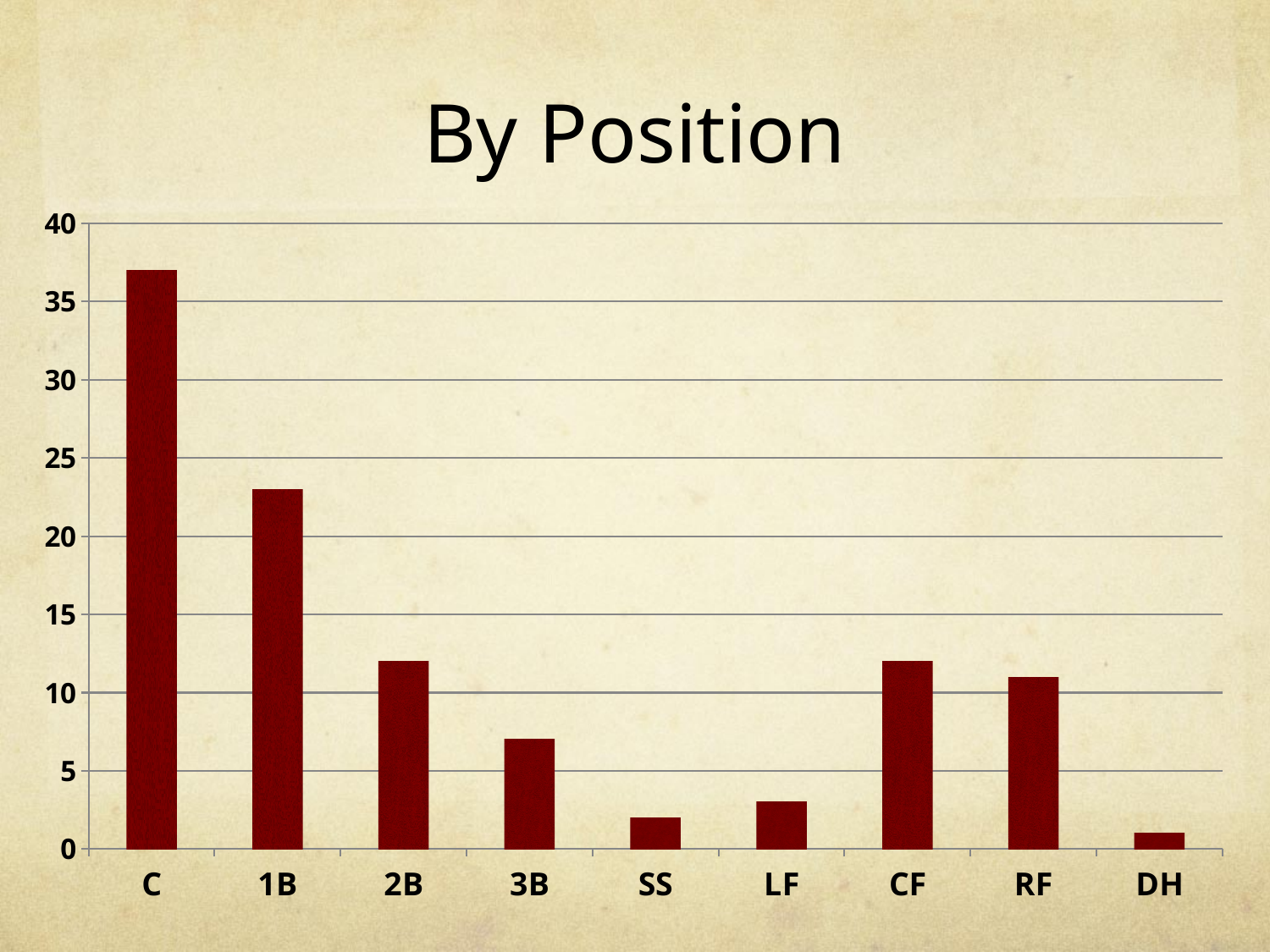
Is the value for 1B greater or less than 20? greater Which has the larger value, 1B or 2B? 1B Is the value for 1B greater or less than 25? less Is the value for 2B greater or less than 10? greater Which position has the lowest value? DH Which has the larger value, LF or SS? LF Which position has the highest value? C What is the title of the chart? By Position How many positions are shown on the x axis? 9 What kind of chart is shown on the slide? bar chart